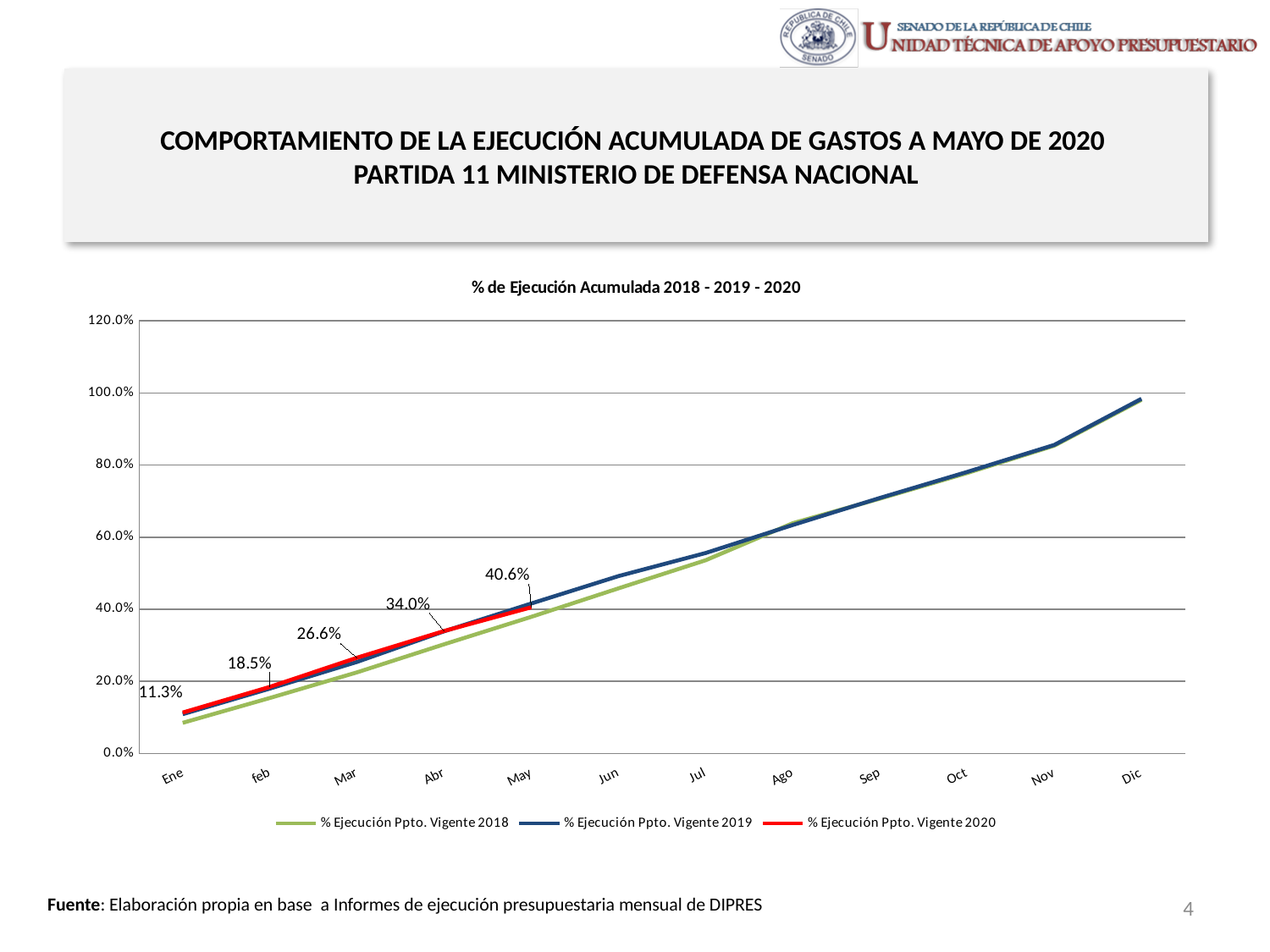
What is the value of % Ejecución Ppto. Vigente 2020 in Mar? 26.6% What is the value of % Ejecución Ppto. Vigente 2020 in Ene? 11.3% Do the values of % Ejecución Ppto. Vigente 2019 rise or fall from Ene to Dic? Rise What is the value of % Ejecución Ppto. Vigente 2020 in May? 40.6% Is the value of % Ejecución Ppto. Vigente 2019 in Dic greater or less than 80.0%? greater What is the value of % Ejecución Ppto. Vigente 2020 in Abr? 34.0% By how many percentage points did % Ejecución Ppto. Vigente 2020 increase from Ene to May? 29.3 percentage points How many months are shown on the x axis? 12 What kind of chart is shown on the slide? Line chart How many series does the legend list? 3 What is the title of the chart? % de Ejecución Acumulada 2018 - 2019 - 2020 In which month does the % Ejecución Ppto. Vigente 2020 series reach its highest labelled value? May